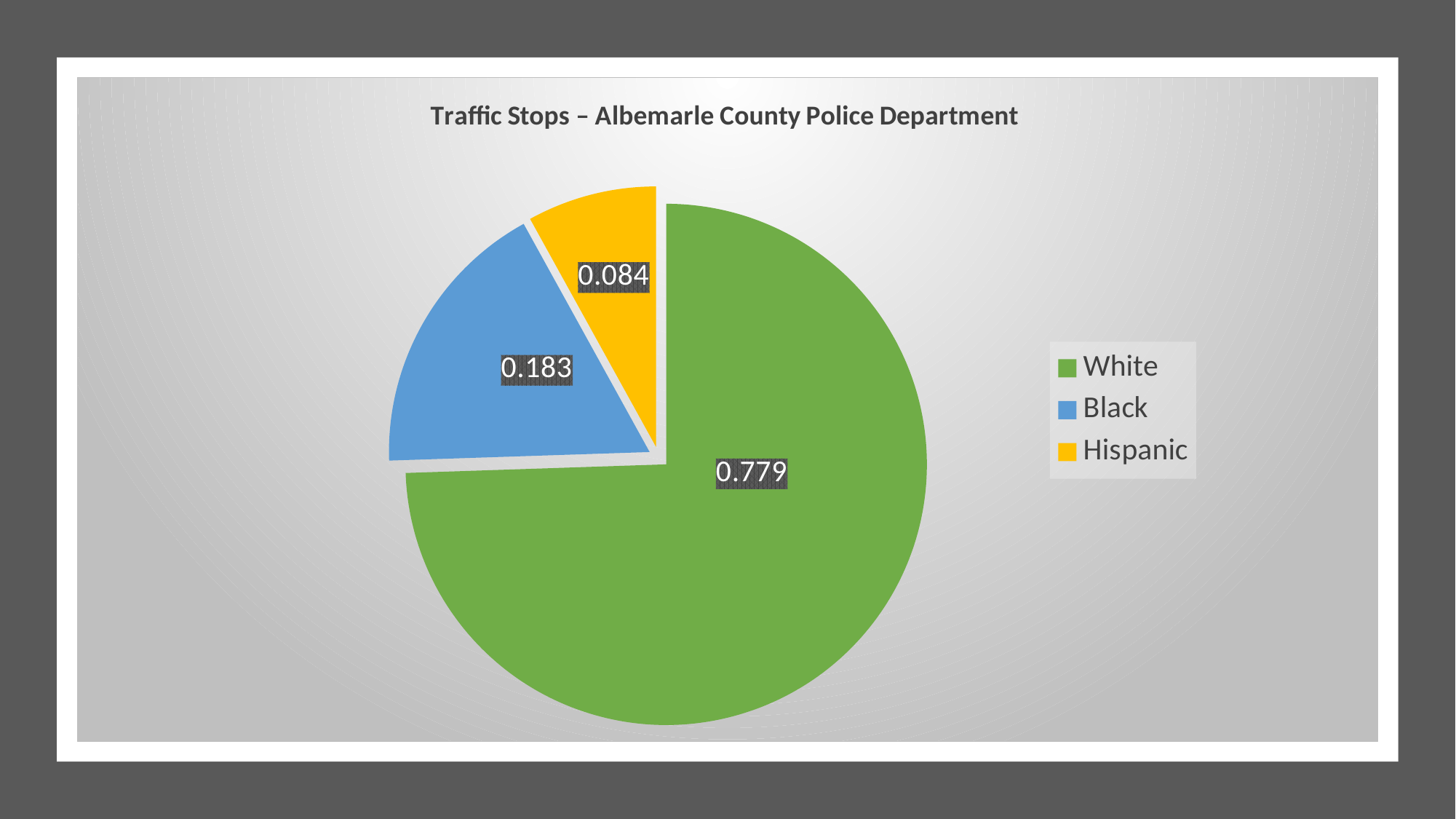
Which category has the largest slice? White Which colour represents Hispanic in the chart? yellow What is the value for White? 0.779 Which category has the smallest slice? Hispanic What kind of chart is shown on the slide? pie chart What is the difference between the values for White and Black? 0.596 What is the value for Black? 0.183 What is the difference between the values for Black and Hispanic? 0.099 How many categories does the legend list? 3 What is the value for Hispanic? 0.084 What is the title of the chart? Traffic Stops – Albemarle County Police Department Which is larger, the value for Black or the value for Hispanic? Black